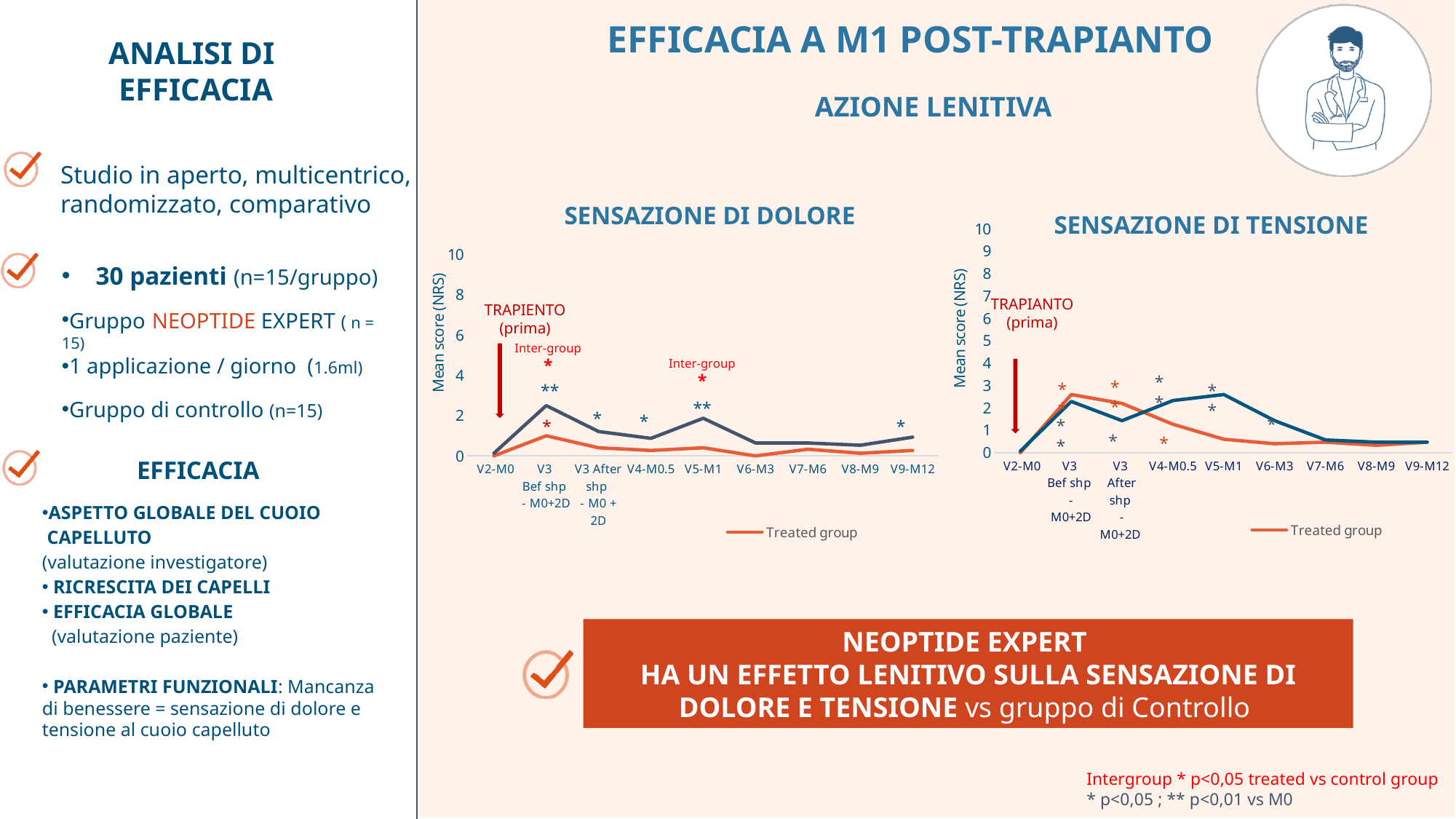
What is the y-axis label of the SENSAZIONE DI TENSIONE chart? Mean score (NRS) In the SENSAZIONE DI TENSIONE chart, is the Treated group value at V3 Bef shp - M0+2D greater or less than 2? greater In the SENSAZIONE DI TENSIONE chart, is the dark line's value at V5-M1 greater or less than 2? greater In the SENSAZIONE DI DOLORE chart, at which x-axis category does the Treated group reach its highest value? V3 Bef shp - M0+2D What type of chart is the SENSAZIONE DI DOLORE chart? Line chart In the SENSAZIONE DI TENSIONE chart, does the Treated group line rise or fall from V3 Bef shp - M0+2D to V9-M12? Fall In the SENSAZIONE DI DOLORE chart, is the Treated group value at V3 Bef shp - M0+2D greater or less than 2? less How many series does the legend of the SENSAZIONE DI DOLORE chart list? 1 In the SENSAZIONE DI DOLORE chart, at V3 Bef shp - M0+2D, which line is higher: the Treated group line or the dark line? The dark line How many categories are shown on the x axis of the SENSAZIONE DI TENSIONE chart? 9